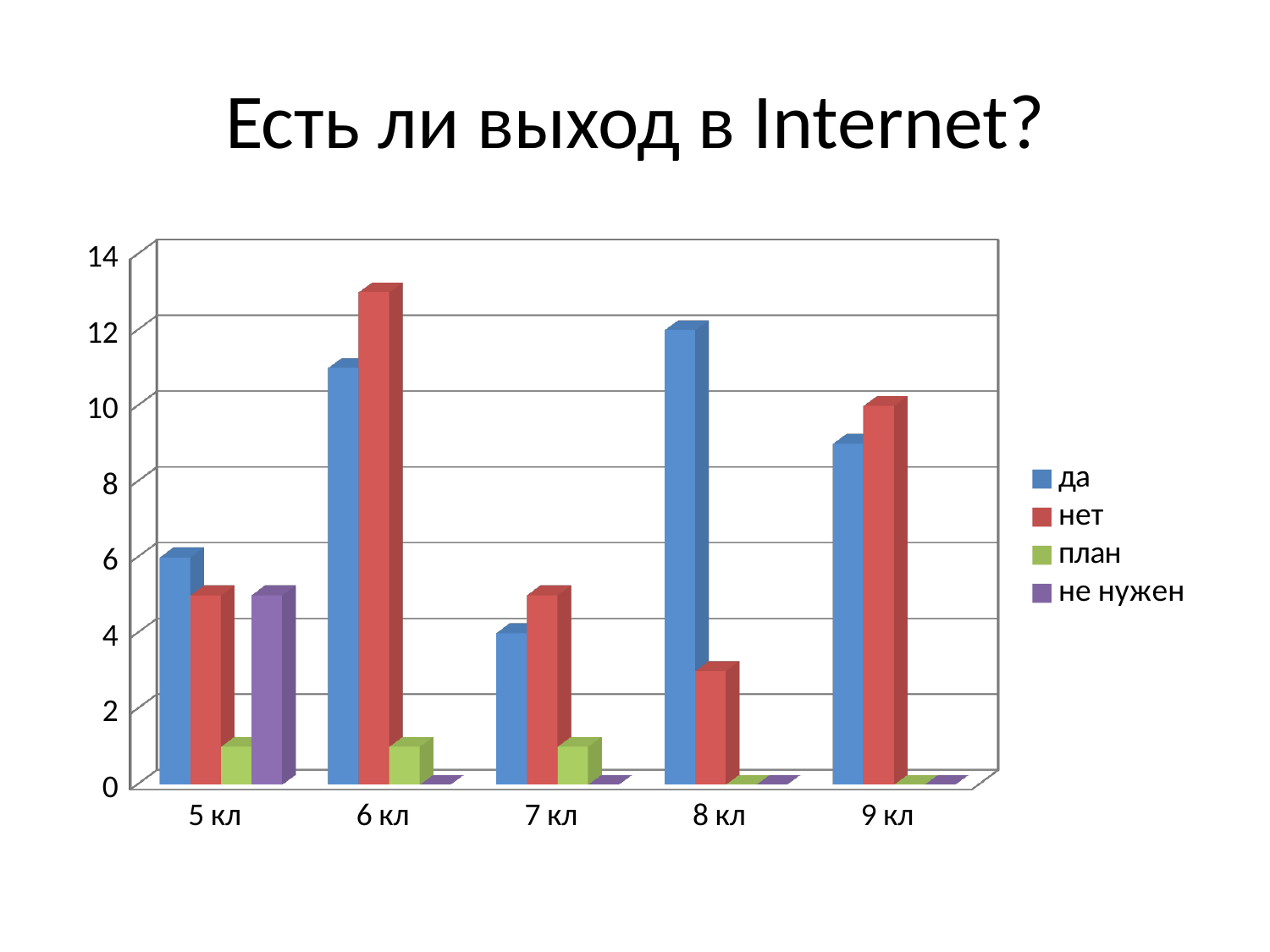
Which class has the highest value for the 'да' series? 8 кл How many series does the legend list? 4 What kind of chart is shown on the slide? bar chart For 8 кл, which is larger: the 'да' value or the 'нет' value? да Which class has the highest value for the 'нет' series? 6 кл Is the 'да' value for 8 кл greater or less than 10? greater Is the 'нет' value for 8 кл greater or less than 4? less Is the 'нет' value for 6 кл greater or less than 12? greater What is the title of the slide? Есть ли выход в Internet? For 6 кл, which is larger: the 'да' value or the 'нет' value? нет Which class has the lowest value for the 'да' series? 7 кл How many categories (classes) are shown on the x axis? 5